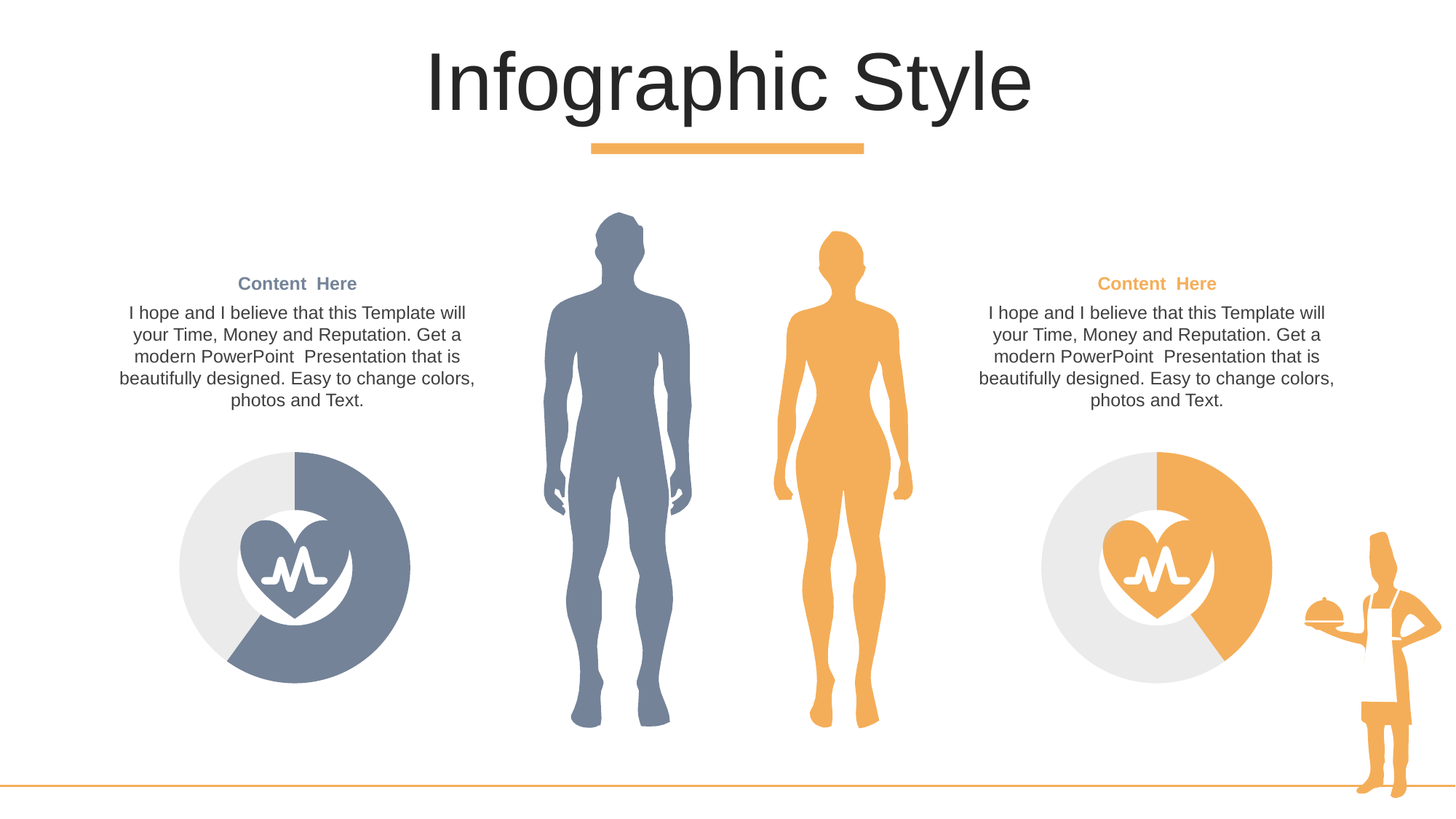
What kind of chart is shown on the right side of the slide, below the right 'Content Here' text? doughnut chart What kind of chart is shown on the left side of the slide, below the left 'Content Here' text? doughnut chart What icon is placed in the centre of each pie chart? a heart with a heartbeat line In the right pie chart, how many slices are there? 2 In the right pie chart, which slice is larger, the orange slice or the light grey slice? the light grey slice In the left pie chart, how many slices are there? 2 What colour is the highlighted slice in the right pie chart? orange In the left pie chart, which slice is larger, the blue-grey slice or the light grey slice? the blue-grey slice